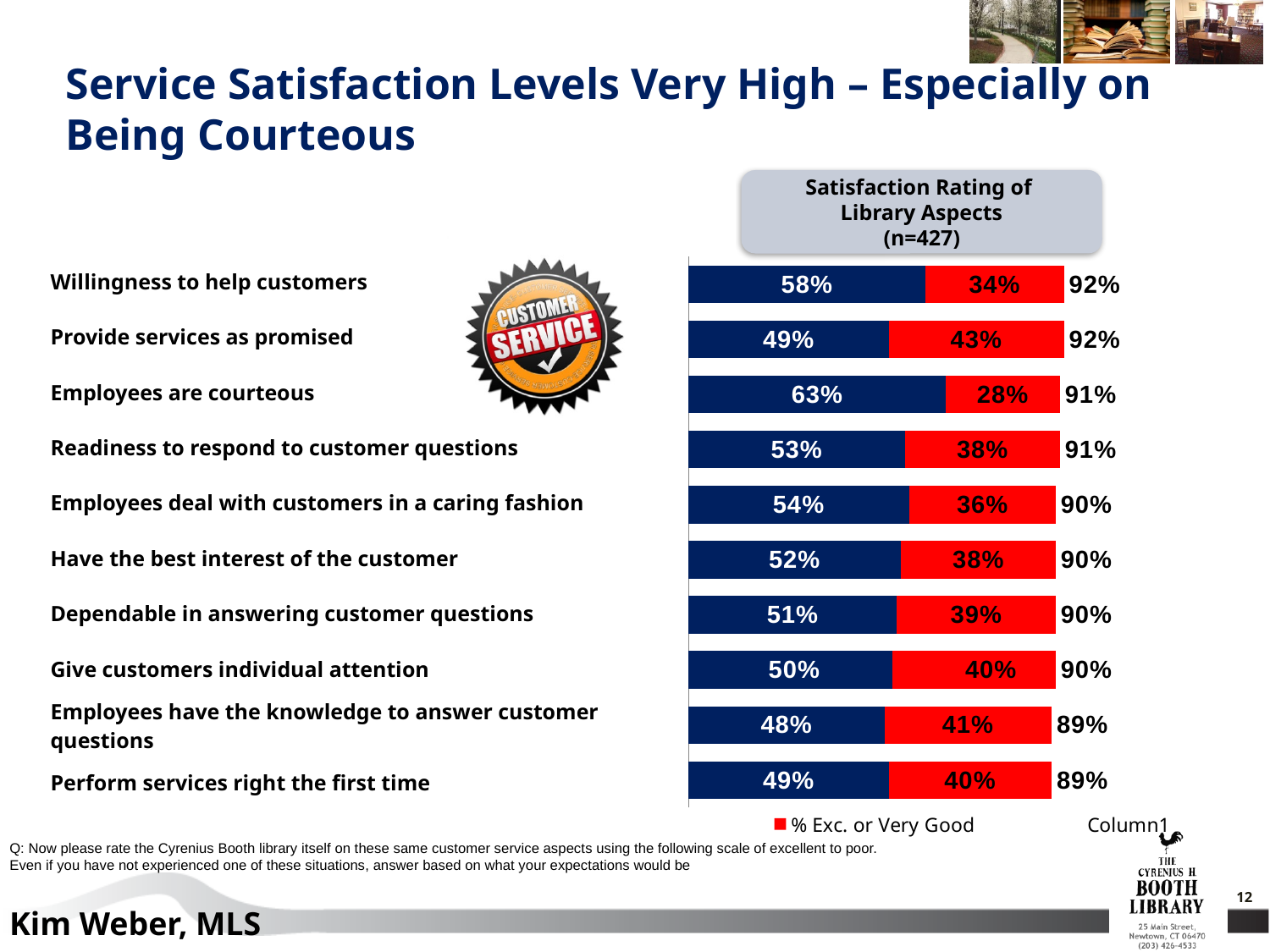
Which aspect has the lowest value in the red segment? Employees are courteous What type of chart is shown on the slide? Stacked bar chart What is the value of the blue segment for "Employees are courteous"? 63% How many library service aspects (categories) are plotted in the chart? 10 Which has the larger blue segment: "Readiness to respond to customer questions" or "Employees deal with customers in a caring fashion"? Employees deal with customers in a caring fashion How much larger is the blue segment for "Employees are courteous" than the blue segment for "Willingness to help customers"? 5 percentage points What is the value of the red segment for "Provide services as promised"? 43% Which aspect has the highest value in the blue segment? Employees are courteous What is the total percentage shown for "Perform services right the first time"? 89% What is the lowest total percentage shown at the end of any bar? 89% What is the total percentage shown at the end of the bar for "Willingness to help customers"? 92% What sample size (n) is stated in the chart title box? n=427